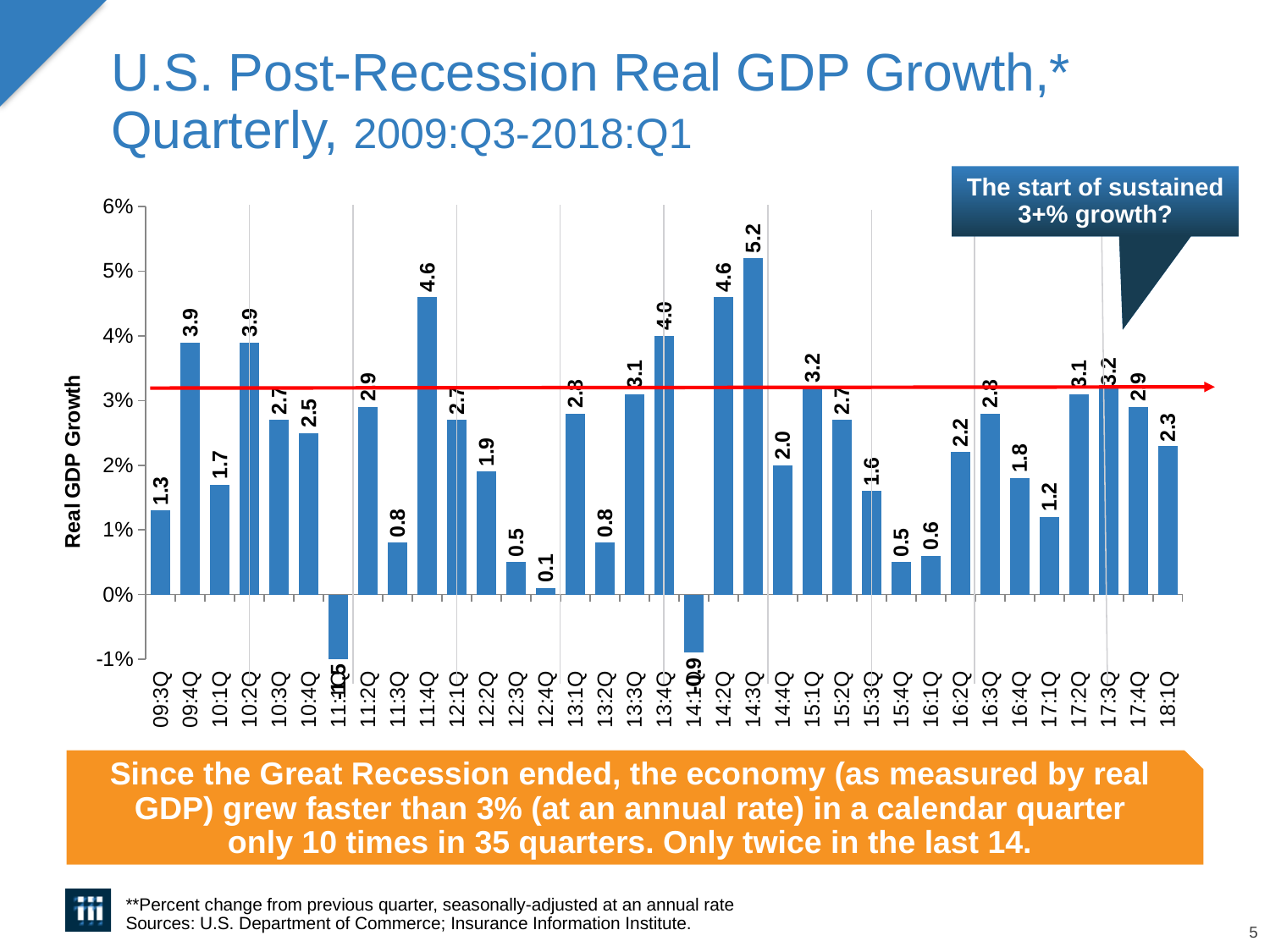
How many quarters are plotted in the chart? 35 What kind of chart is shown on the slide? Bar chart Which quarter has the lowest real GDP growth? 11:1Q What is the difference between the values for 14:3Q and 14:2Q? 0.6 What is the difference between the values for 13:4Q and 13:3Q? 0.9 What is the real GDP growth value for 18:1Q? 2.3 What is the label on the vertical axis of the chart? Real GDP Growth Which is larger, the value for 09:4Q or the value for 10:1Q? 09:4Q Which quarter has the highest real GDP growth? 14:3Q What is the real GDP growth value for 11:4Q? 4.6 What is the real GDP growth value for 12:4Q? 0.1 What is the real GDP growth value for 14:3Q? 5.2